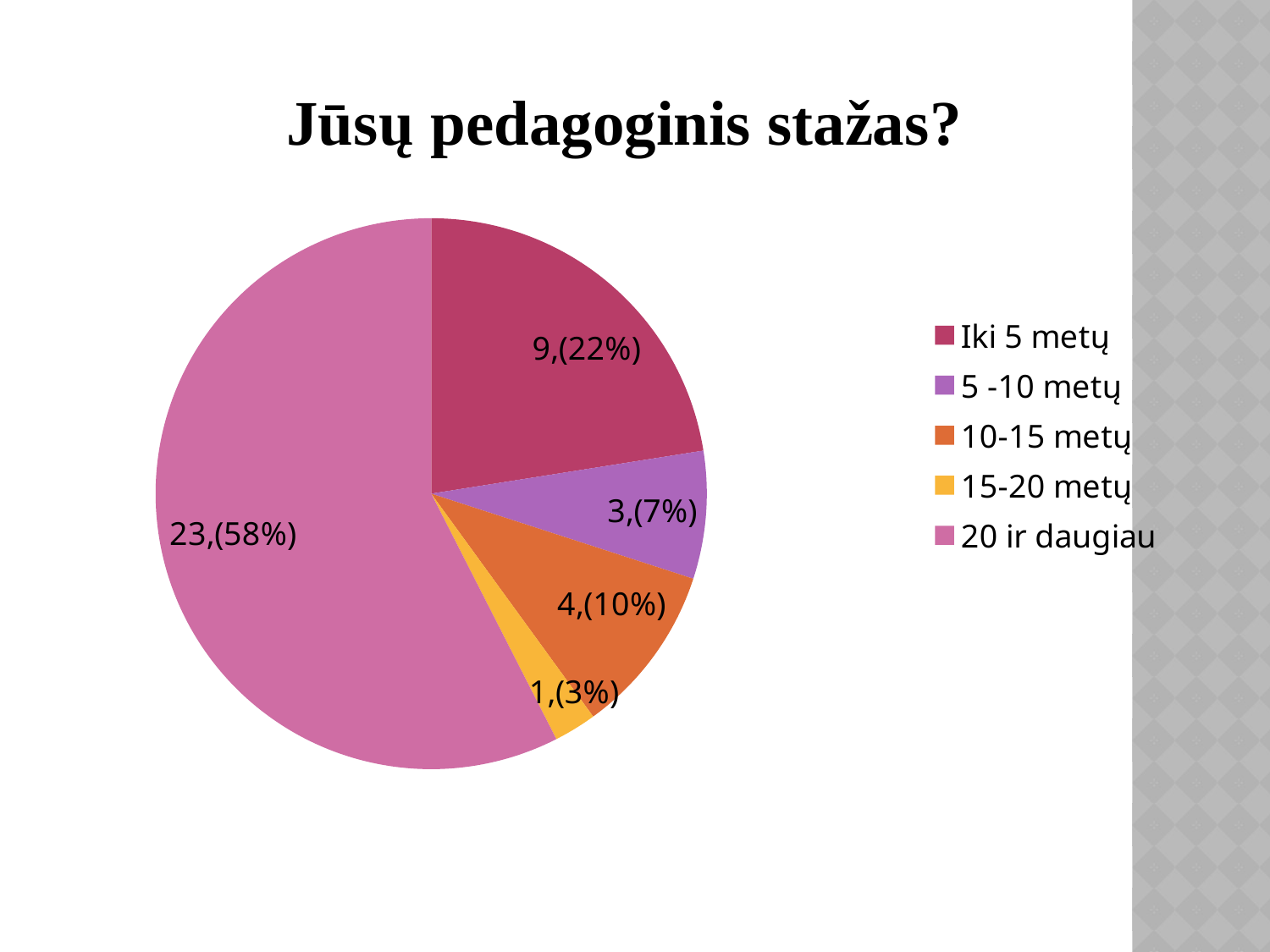
What is the data label for the '20 ir daugiau' slice? 23,(58%) What is the title of the chart? Jūsų pedagoginis stažas? What is the difference in count between the '20 ir daugiau' slice and the 'Iki 5 metų' slice? 14 What is the data label for the '10-15 metų' slice? 4,(10%) Which is larger, the 'Iki 5 metų' slice or the '10-15 metų' slice? Iki 5 metų What is the data label for the '5 -10 metų' slice? 3,(7%) What kind of chart is shown on the slide? pie chart What share of the pie does the '15-20 metų' slice represent? 3% What is the data label for the 'Iki 5 metų' slice? 9,(22%) Which category has the smallest slice? 15-20 metų Which category has the largest slice? 20 ir daugiau How many categories does the legend list? 5